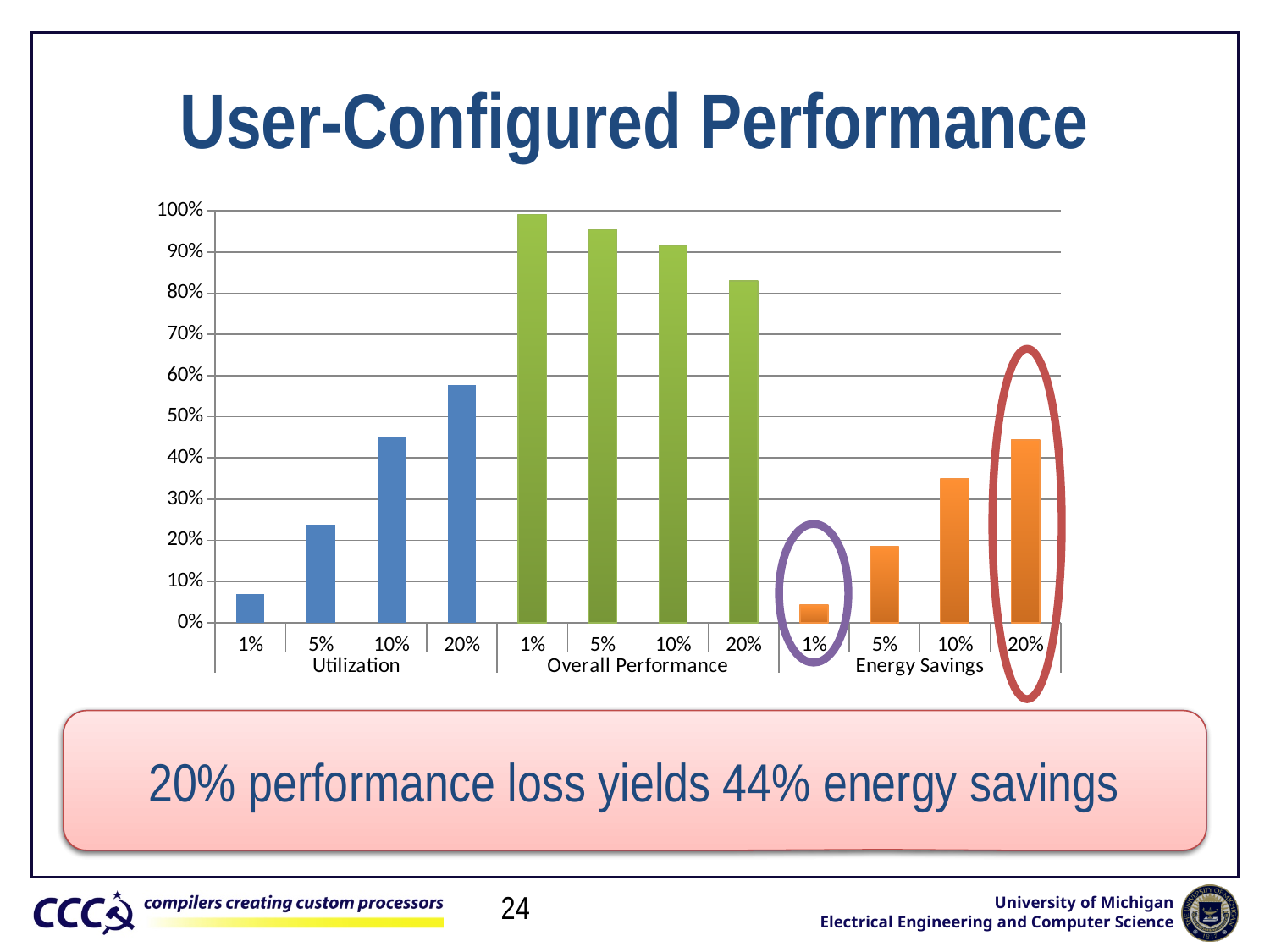
Within the Energy Savings group, which setting has the highest bar? 20% Is the Utilization value at 20% greater or less than 50%? greater Is the Energy Savings value at 1% greater or less than 10%? less What is the title of the slide containing the chart? User-Configured Performance Which bar in the chart is the tallest? Overall Performance at 1% Is the Overall Performance value at 1% greater or less than 90%? greater Which is larger: the Utilization bar at 20% or the Energy Savings bar at 20%? Utilization at 20% Do the Overall Performance bars rise or fall as the setting goes from 1% to 20%? fall How many category groups are labelled along the x axis of the chart? 3 How many bars are plotted in the chart? 12 Which bar in the chart is the shortest? Energy Savings at 1% What kind of chart is shown on the slide? bar chart